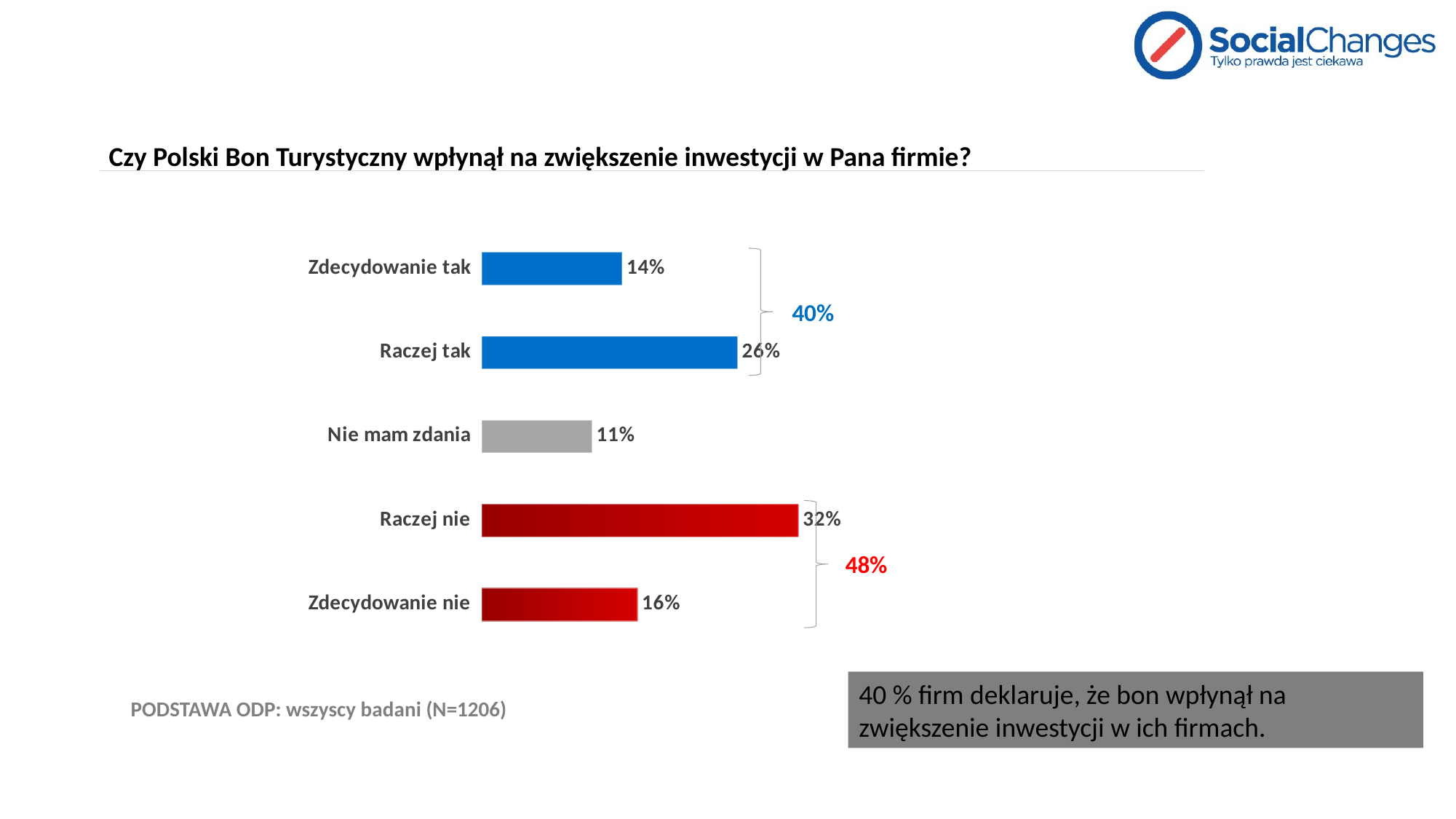
What percentage of respondents answered "Zdecydowanie nie"? 16% How many answer categories are shown in the chart? 5 Which answer category has the lowest percentage? Nie mam zdania What percentage of respondents answered "Raczej tak"? 26% What percentage of respondents answered "Raczej nie"? 32% What combined percentage is shown for the two "nie" answers (Raczej nie and Zdecydowanie nie)? 48% What kind of chart is shown on the slide? Bar chart What is the difference in percentage points between "Raczej nie" and "Raczej tak"? 6 percentage points What percentage of respondents answered "Nie mam zdania"? 11% Which answer category has the highest percentage? Raczej nie Which is larger, the value for "Zdecydowanie nie" or the value for "Zdecydowanie tak"? Zdecydowanie nie What percentage of respondents answered "Zdecydowanie tak"? 14%